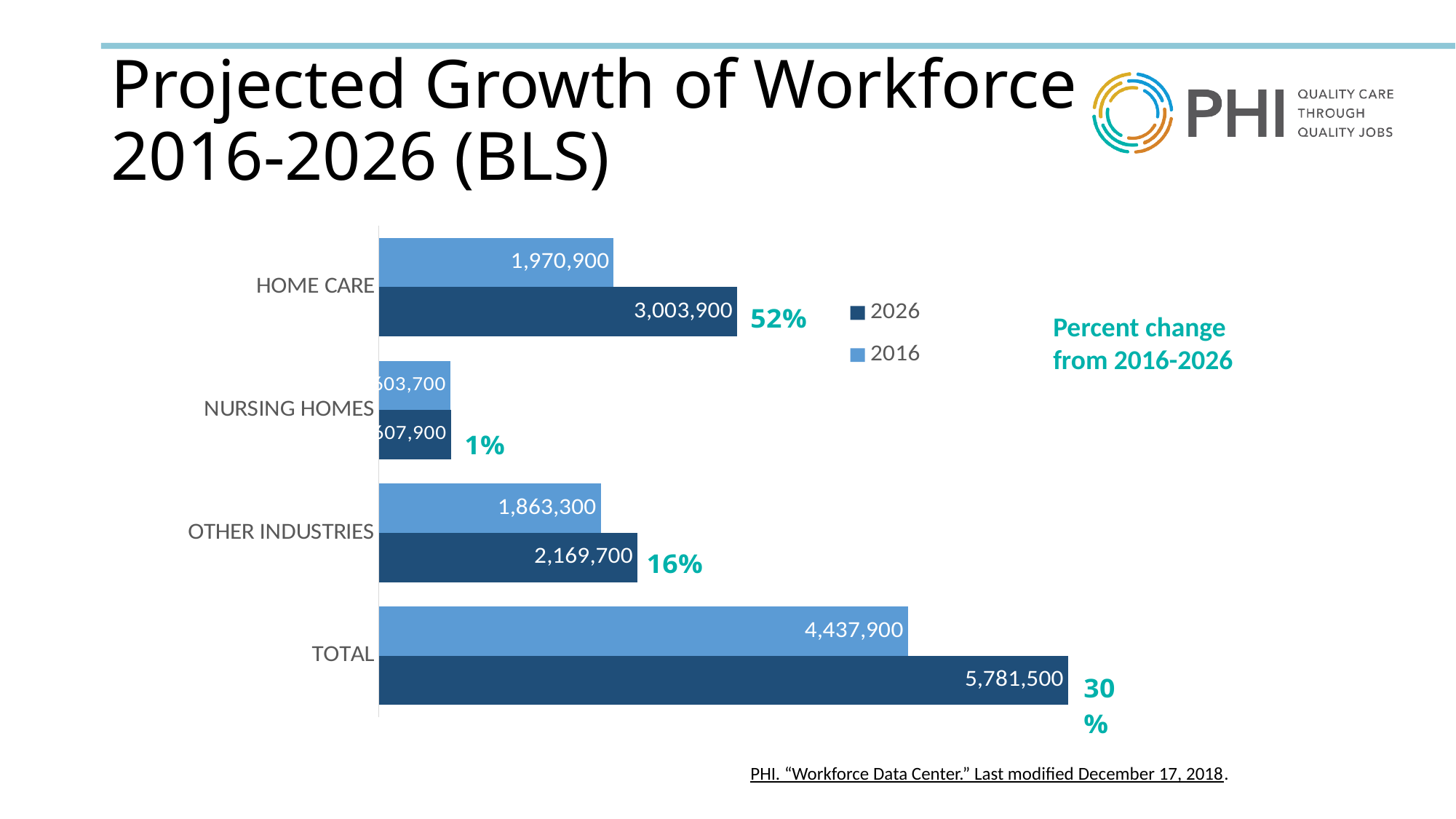
What is the difference between the 2026 and 2016 values for Total? 1,343,600 What is the 2026 value for Home Care? 3,003,900 Which category has the lowest 2026 value? Nursing Homes What is the percent change from 2016-2026 shown for Home Care? 52% What is the 2016 value for Home Care? 1,970,900 What kind of chart is shown on the slide? Bar chart What is the 2026 value for Other Industries? 2,169,700 How many series does the legend list? 2 What is the 2016 value for Total? 4,437,900 Which is larger, the 2026 value for Home Care or the 2026 value for Other Industries? Home Care What is the percent change from 2016-2026 shown for Other Industries? 16% What is the difference between the 2026 and 2016 values for Home Care? 1,033,000